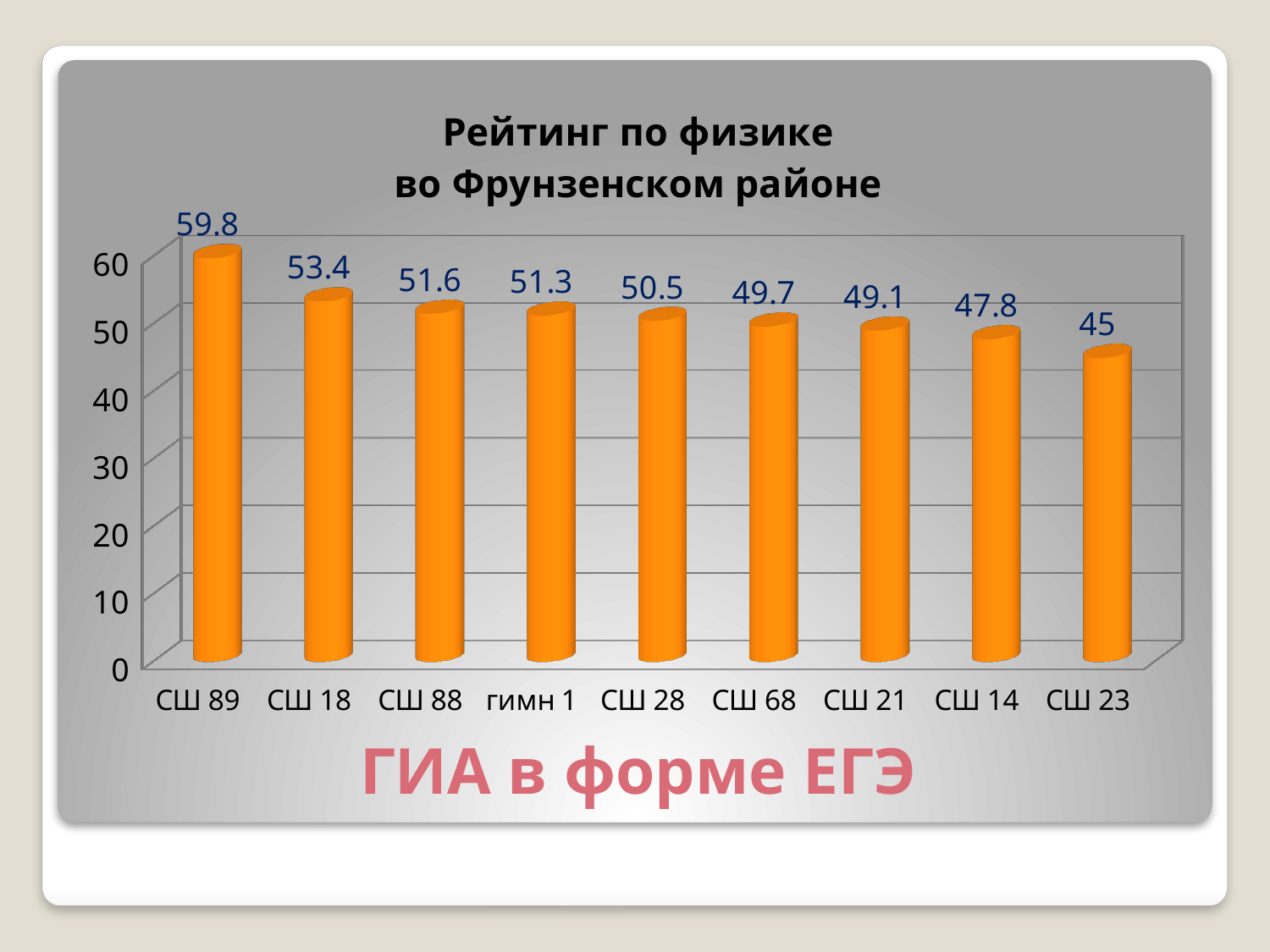
Which school has the highest value? СШ 89 Do the values rise or fall from left to right along the x axis? fall How many schools are shown on the chart? 9 What is the difference between the values for СШ 89 and СШ 18? 6.4 What is the value for гимн 1? 51.3 What kind of chart is shown on the slide? bar chart What is the value for СШ 23? 45 Is the value for СШ 21 greater or less than 50? less Which is larger, the value for СШ 88 or the value for СШ 68? СШ 88 Which school has the lowest value? СШ 23 What is the value for СШ 89? 59.8 What is the difference between the values for СШ 14 and СШ 23? 2.8